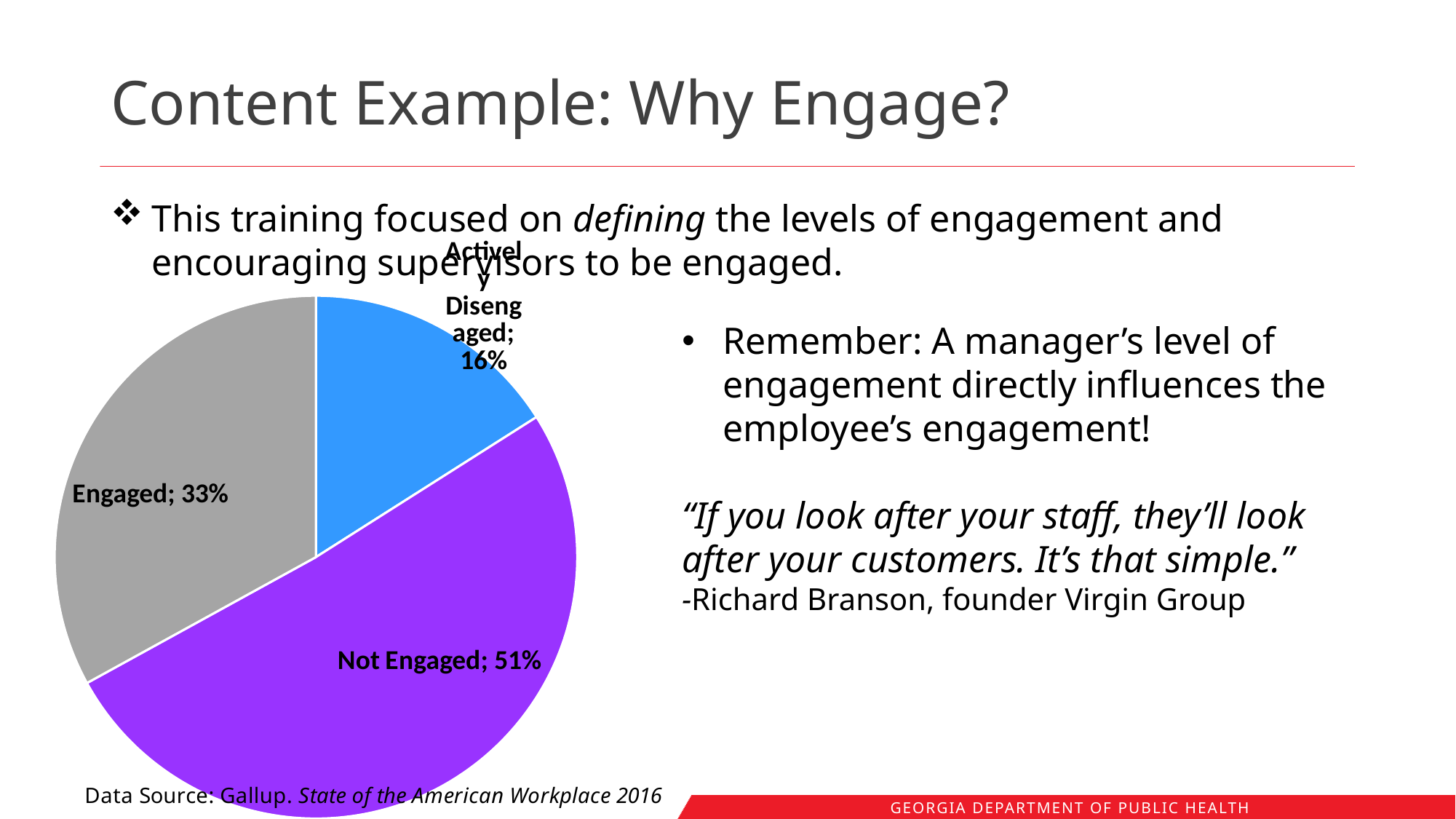
What percentage of the pie is labelled Not Engaged? 51% What is the difference in percentage points between the Engaged and Actively Disengaged slices? 17 What colour is the Not Engaged slice? purple What colour is the Engaged slice? gray Which is larger, the Engaged slice or the Actively Disengaged slice? Engaged How many slices does the pie chart have? 3 Which slice of the pie is the largest? Not Engaged Which slice of the pie is the smallest? Actively Disengaged What is the difference in percentage points between the Not Engaged and Engaged slices? 18 What percentage of the pie is labelled Engaged? 33% What percentage of the pie is labelled Actively Disengaged? 16% What kind of chart is shown on the slide? pie chart